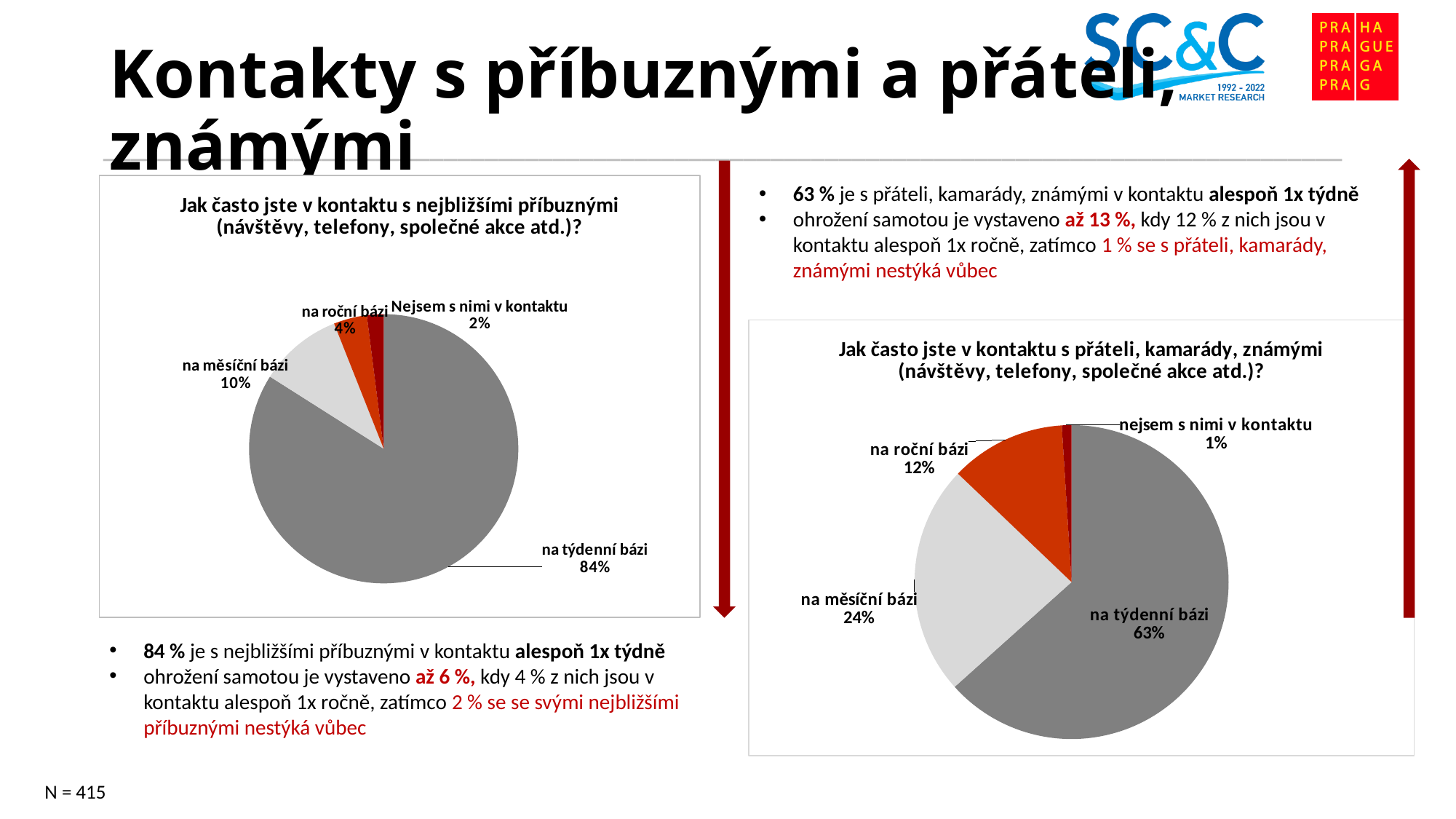
In the left pie chart (contact with closest relatives), what share is 'Nejsem s nimi v kontaktu'? 2% What is the difference between the 'na týdenní bázi' share in the left pie chart and the 'na týdenní bázi' share in the right pie chart? 21 percentage points In the right pie chart (contact with friends and acquaintances), what share is 'na měsíční bázi'? 24% What is the title of the right chart? Jak často jste v kontaktu s přáteli, kamarády, známými (návštěvy, telefony, společné akce atd.)? How many categories does the right pie chart (contact with friends and acquaintances) show? 4 In the right pie chart (contact with friends and acquaintances), what share is 'na roční bázi'? 12% In the right pie chart (contact with friends and acquaintances), which category has the largest share? na týdenní bázi In the left pie chart (contact with closest relatives), which category has the smallest share? Nejsem s nimi v kontaktu In the left pie chart (contact with closest relatives), what share is 'na měsíční bázi'? 10% Which is larger: 'na roční bázi' in the left pie chart or 'na roční bázi' in the right pie chart? Right pie chart (12%) What type of chart is used on the left side of the slide? Pie chart In the left pie chart (contact with closest relatives), what share is 'na týdenní bázi'? 84%